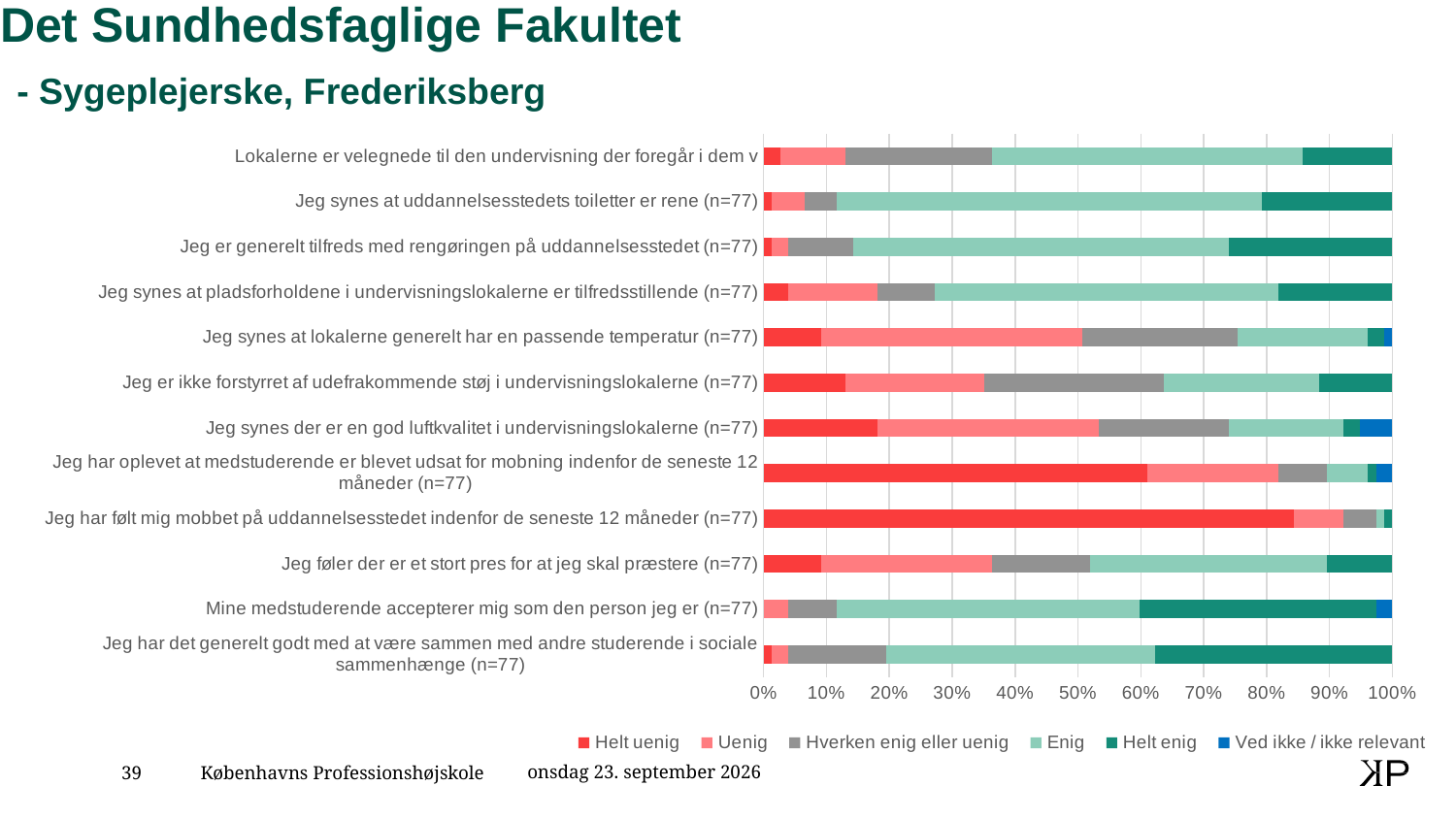
Is the 'Helt uenig' share for 'Jeg synes der er en god luftkvalitet i undervisningslokalerne (n=77)' greater or less than 10%? greater How many series does the legend list? 6 Is the 'Helt uenig' share for 'Jeg har oplevet at medstuderende er blevet udsat for mobning indenfor de seneste 12 måneder (n=77)' greater or less than 50%? greater Is the 'Enig' share for 'Jeg synes at uddannelsesstedets toiletter er rene (n=77)' greater or less than 50%? greater Which series is listed last in the legend? Ved ikke / ikke relevant Which statement has the largest 'Helt uenig' share? Jeg har følt mig mobbet på uddannelsesstedet indenfor de seneste 12 måneder (n=77) What kind of chart is shown on the slide? Stacked bar chart Which series is listed first in the legend? Helt uenig What is the highest value shown on the x axis? 100% How many categories (statements) are plotted on the chart? 12 Which has the larger 'Helt uenig' share: 'Jeg har følt mig mobbet på uddannelsesstedet indenfor de seneste 12 måneder (n=77)' or 'Jeg føler der er et stort pres for at jeg skal præstere (n=77)'? Jeg har følt mig mobbet på uddannelsesstedet indenfor de seneste 12 måneder (n=77)